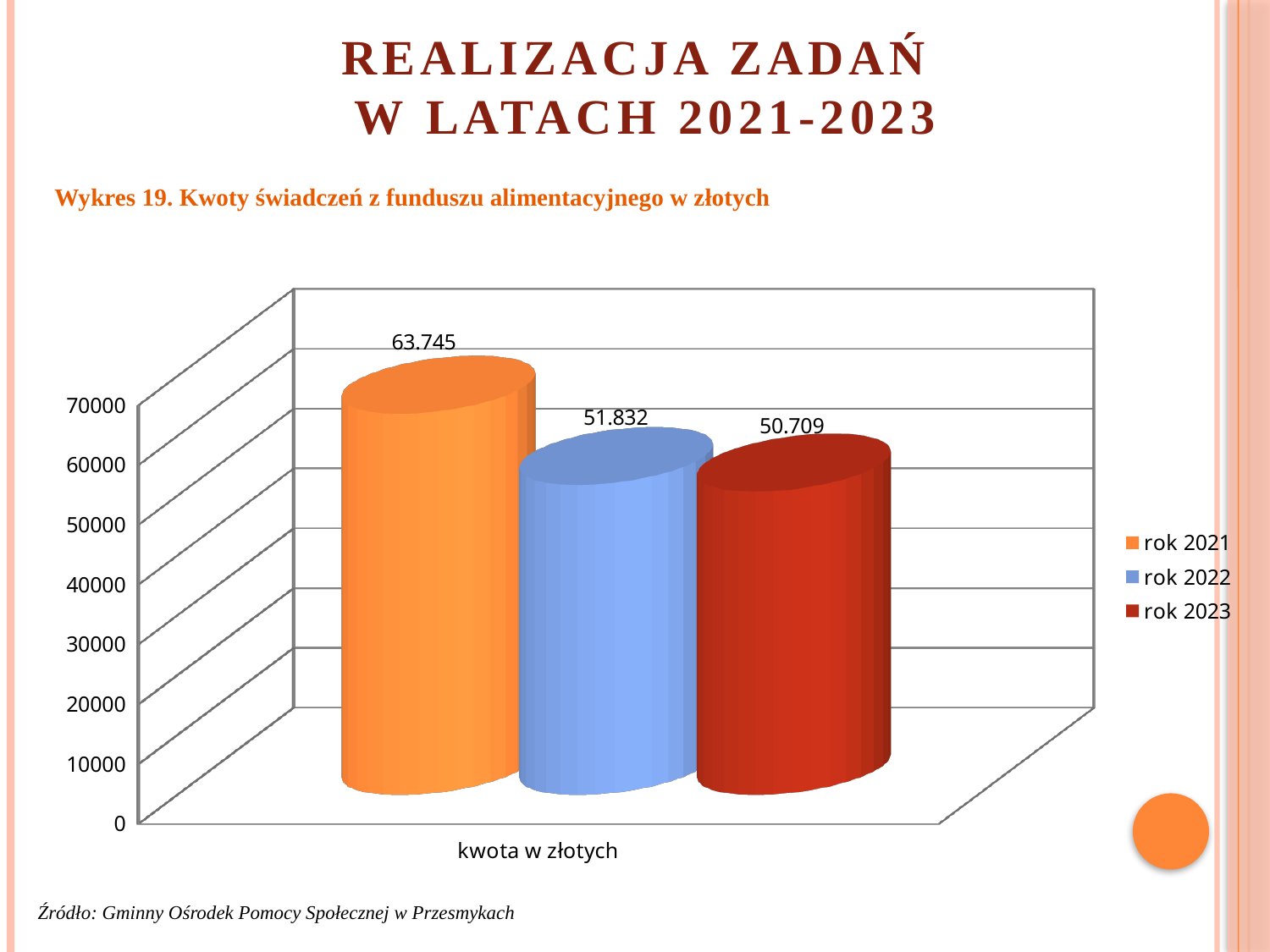
Is the value for rok 2021 greater or less than 60000? greater How many series does the legend list? 3 Which year has the highest value? rok 2021 What is the difference between the values for rok 2021 and rok 2022? 11.913 What is the value for rok 2023? 50.709 What is the value for rok 2021? 63.745 What is the difference between the values for rok 2022 and rok 2023? 1.123 Which year has the lowest value? rok 2023 Do the values rise or fall from rok 2021 to rok 2023? fall What is the value for rok 2022? 51.832 Which is larger, the value for rok 2022 or rok 2023? rok 2022 What kind of chart is shown? bar chart